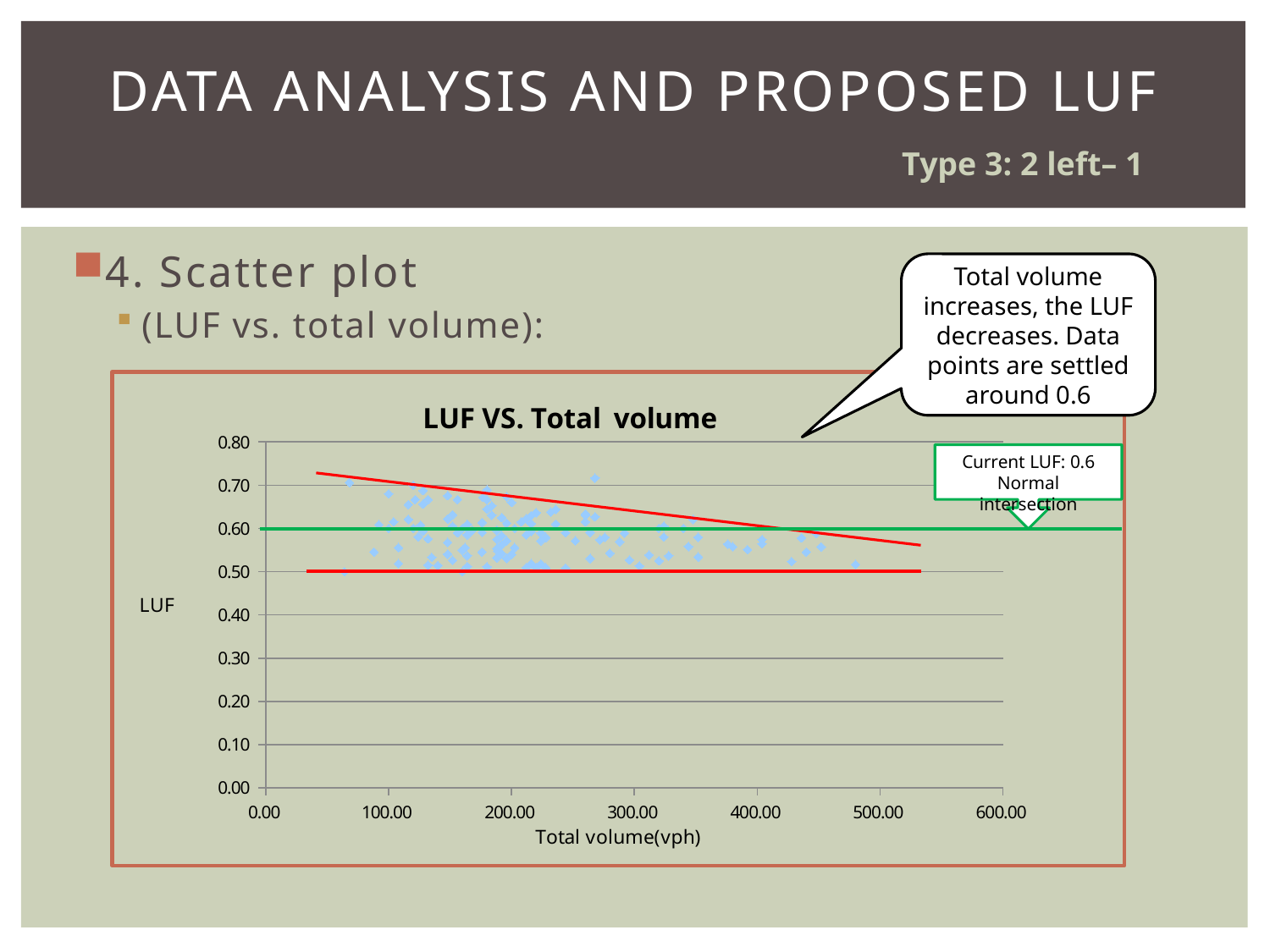
Is the LUF value of the highest plotted point greater or less than 0.60? greater What is the highest tick value shown on the x axis? 600.00 What kind of chart is shown on the slide? Scatter plot What is the label of the x axis of the chart? Total volume(vph) Around what LUF value does the annotation say the data points are settled? 0.6 What is the title of the chart? LUF VS. Total volume Are the plotted LUF values greater or less than 0.80? less As total volume increases along the x axis, does LUF tend to rise or fall? Fall Are the plotted LUF values greater or less than 0.40? greater What is the current LUF value marked by the green horizontal line on the chart? 0.6